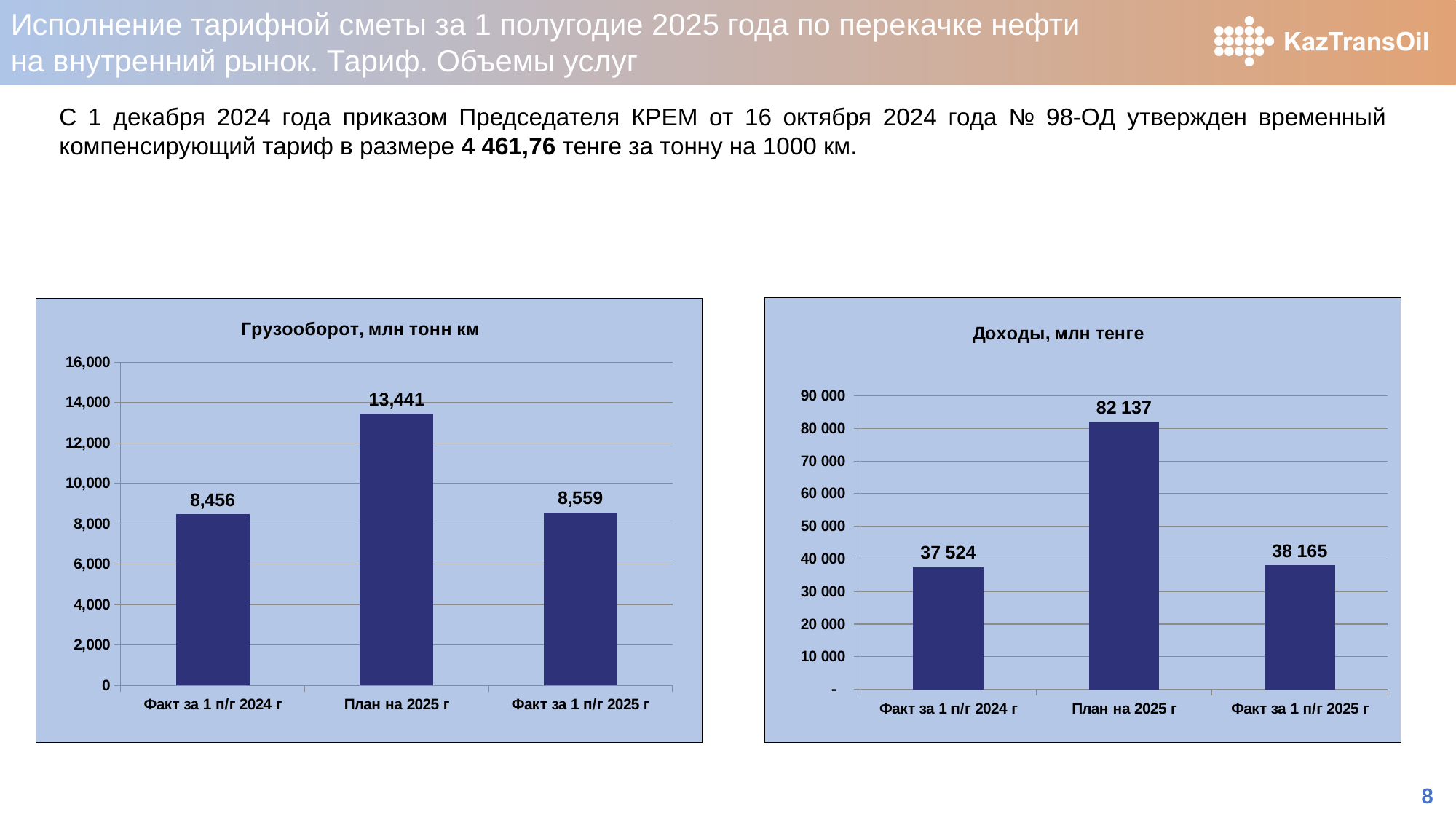
In the chart titled "Грузооборот, млн тонн км", which category has the highest value? План на 2025 г In the chart titled "Грузооборот, млн тонн км", is the value for "План на 2025 г" greater or less than 12,000? greater What kind of chart is the chart titled "Грузооборот, млн тонн км"? bar chart In the chart titled "Грузооборот, млн тонн км", what is the value for "План на 2025 г"? 13,441 In the chart titled "Доходы, млн тенге", what is the difference between "План на 2025 г" and "Факт за 1 п/г 2025 г"? 43 972 In the chart titled "Доходы, млн тенге", which category has the lowest value? Факт за 1 п/г 2024 г In the chart titled "Доходы, млн тенге", which is larger: "Факт за 1 п/г 2024 г" or "Факт за 1 п/г 2025 г"? Факт за 1 п/г 2025 г In the chart titled "Грузооборот, млн тонн км", what is the difference between "Факт за 1 п/г 2025 г" and "Факт за 1 п/г 2024 г"? 103 In the chart titled "Грузооборот, млн тонн км", what is the value for "Факт за 1 п/г 2024 г"? 8,456 In the chart titled "Доходы, млн тенге", what is the value for "Факт за 1 п/г 2025 г"? 38 165 How many categories are shown in the chart titled "Доходы, млн тенге"? 3 In the chart titled "Доходы, млн тенге", what is the value for "План на 2025 г"? 82 137